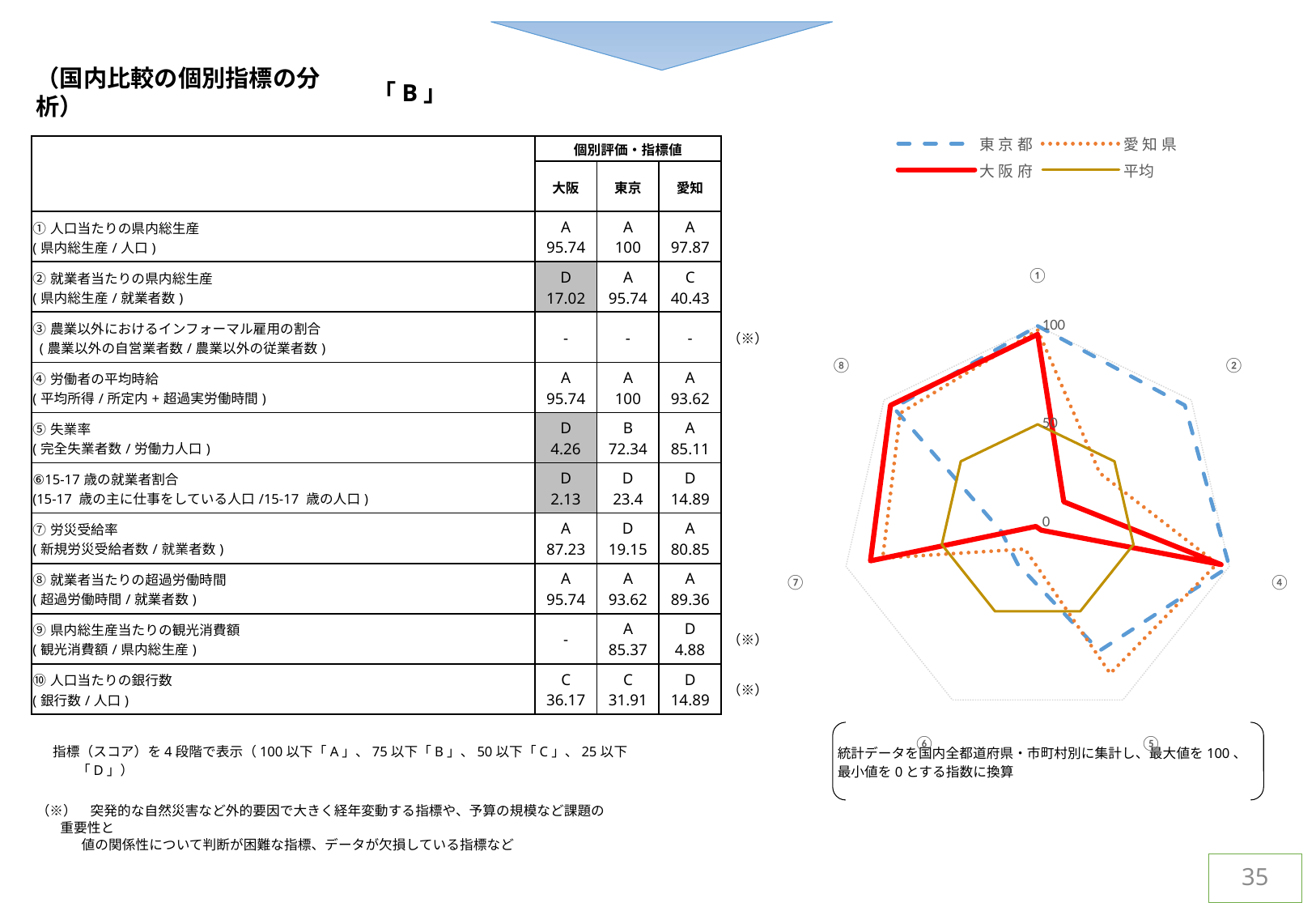
Which series in the radar chart is drawn with a blue dashed line? 東京都 In the radar chart, is the value for 大阪府 on axis ② greater or less than 50? less In the radar chart, which series has the highest value on axis ②? 東京都 What kind of chart is shown on the right side of the slide? radar chart In the radar chart, is the value for 大阪府 on axis ⑤ greater or less than 50? less In the radar chart, is the value for 東京都 on axis ② greater or less than 50? greater Which series in the radar chart is drawn with a thick solid red line? 大阪府 How many axes (indicators) does the radar chart have? 7 How many series does the legend of the radar chart list? 4 In the radar chart, which series has the higher value on axis ②, 東京都 or 大阪府? 東京都 In the radar chart, which series has the higher value on axis ⑦, 大阪府 or 東京都? 大阪府